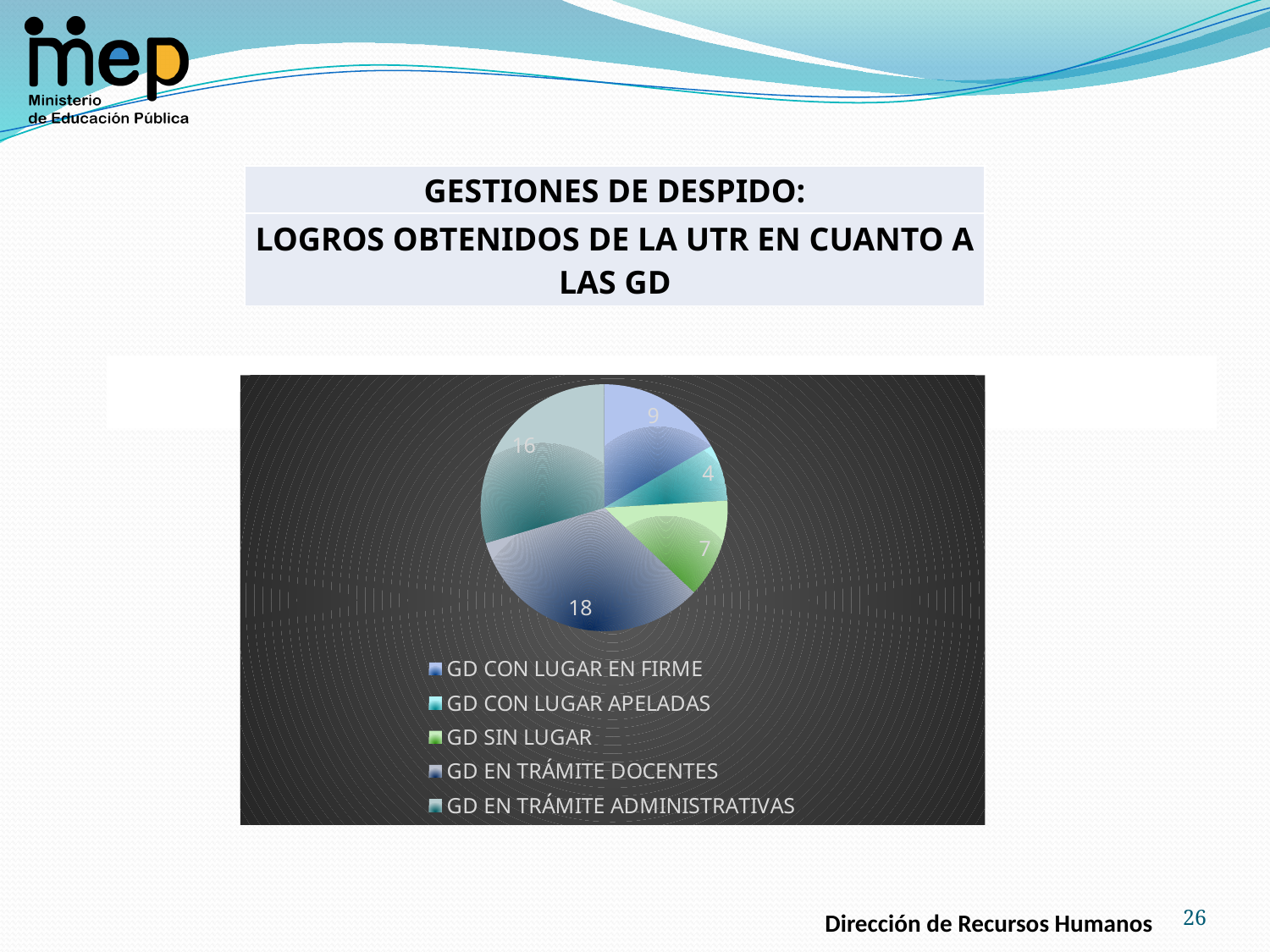
Which category has the largest slice of the pie? GD EN TRÁMITE DOCENTES What is the title shown above the chart? GESTIONES DE DESPIDO: LOGROS OBTENIDOS DE LA UTR EN CUANTO A LAS GD What is the value for GD CON LUGAR APELADAS? 4 How many slices does the pie chart have? 5 Which is larger, the value for GD SIN LUGAR or the value for GD CON LUGAR EN FIRME? GD CON LUGAR EN FIRME What is the value for GD EN TRÁMITE ADMINISTRATIVAS? 16 What is the value for GD SIN LUGAR? 7 What is the difference between the values for GD EN TRÁMITE DOCENTES and GD CON LUGAR EN FIRME? 9 Which category has the smallest slice of the pie? GD CON LUGAR APELADAS What is the total of all the values in the pie chart? 54 What kind of chart is shown on the slide? Pie chart What is the value for GD EN TRÁMITE DOCENTES? 18